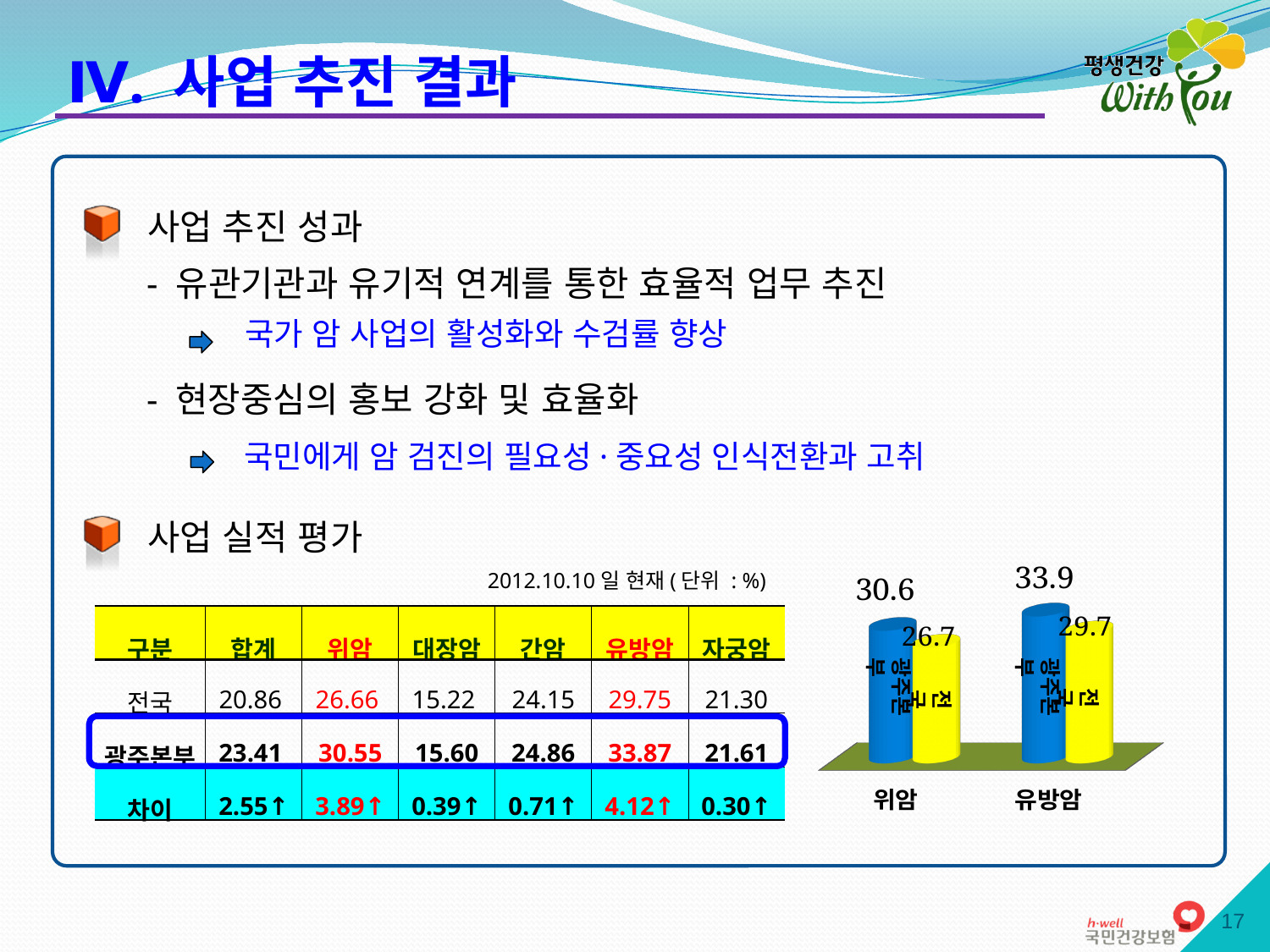
What colour are the 광주본부 bars in the chart? blue Which bar in the chart has the lowest value? 전국 for 위암 What is the value of the yellow (전국) bar for 유방암 in the chart? 29.7 How many categories are shown on the x axis of the chart? 2 What is the value of the blue (광주본부) bar for 위암 in the chart? 30.6 In the chart, which is larger for 유방암: the 광주본부 value or the 전국 value? 광주본부 What is the value of the blue (광주본부) bar for 유방암 in the chart? 33.9 What kind of chart is shown on the slide? bar chart What is the difference between the 광주본부 and 전국 values for 유방암 in the chart? 4.2 What is the value of the yellow (전국) bar for 위암 in the chart? 26.7 Which bar in the chart has the highest value? 광주본부 for 유방암 What is the difference between the 광주본부 and 전국 values for 위암 in the chart? 3.9